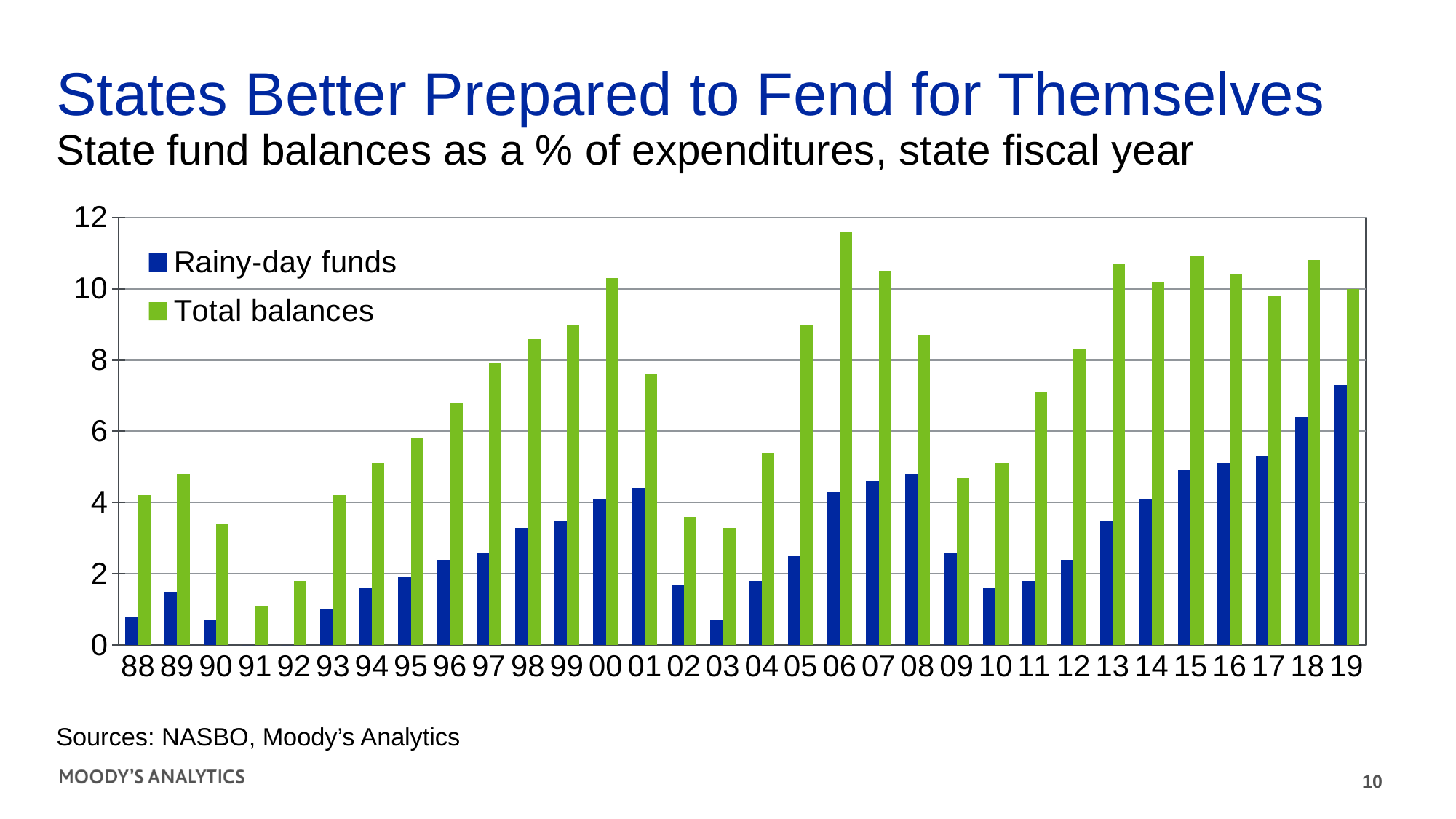
In which fiscal year is the Rainy-day funds value highest? 19 How many fiscal years are shown along the x axis? 32 How many series does the legend list? 2 Which is larger, the Rainy-day funds value for 18 or for 17? 18 In which fiscal year is the Total balances value lowest? 91 Do the Rainy-day funds values rise or fall from 13 to 19? rise Is the Rainy-day funds value for 88 greater or less than 2? less In which fiscal year is the Total balances value highest? 06 Is the Total balances value for 06 greater or less than 10? greater Which is larger, the Total balances value for 13 or for 12? 13 What kind of chart is shown on the slide? Bar chart Is the Rainy-day funds value for 19 greater or less than 6? greater